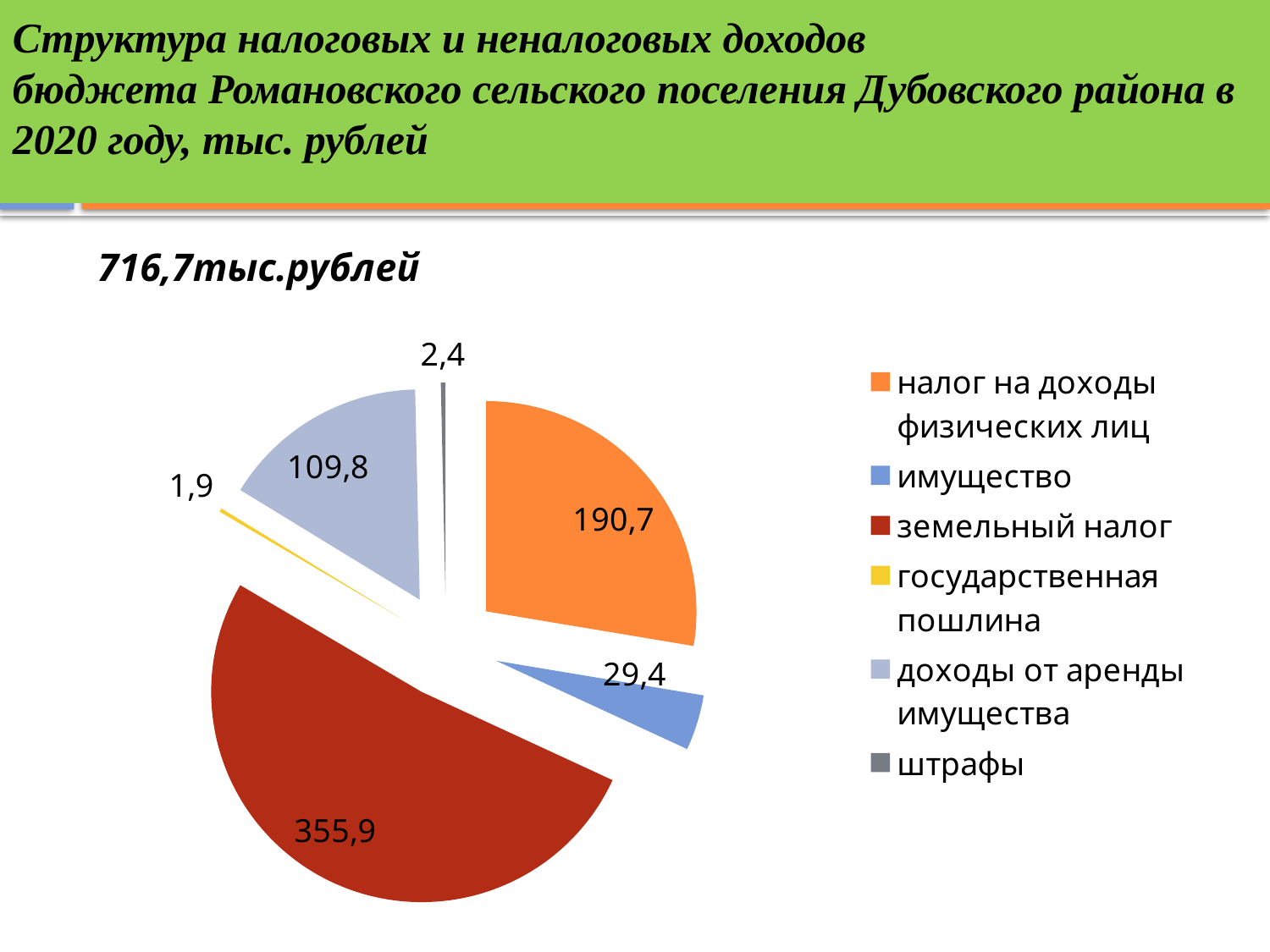
What is the value for земельный налог? 355,9 How many categories does the pie chart have? 6 What is the difference between земельный налог and налог на доходы физических лиц? 165,2 Which category has the smallest slice of the pie? государственная пошлина Which category has the largest slice of the pie? земельный налог What is the value for налог на доходы физических лиц? 190,7 What is the value for штрафы? 2,4 Which is larger, доходы от аренды имущества or имущество? доходы от аренды имущества What is the value for доходы от аренды имущества? 109,8 What type of chart is shown on the slide? pie chart What colour is the slice for земельный налог? dark red What is the value for имущество? 29,4